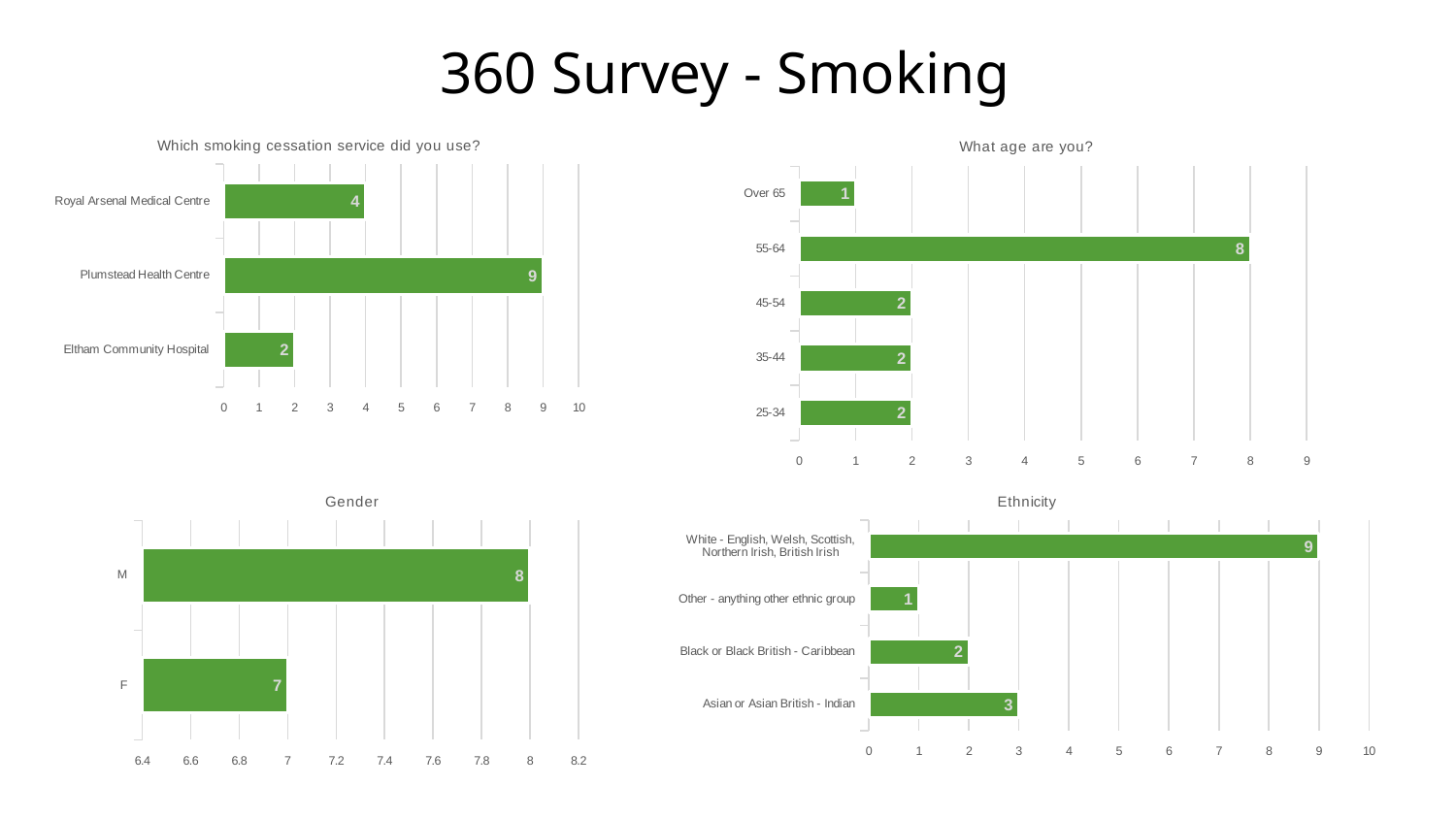
In the 'Which smoking cessation service did you use?' chart, what is the difference between Plumstead Health Centre and Royal Arsenal Medical Centre? 5 In the 'Which smoking cessation service did you use?' chart, what is the value for Plumstead Health Centre? 9 In the 'Gender' chart, what is the value for F? 7 In the 'Ethnicity' chart, what is the difference between White - English, Welsh, Scottish, Northern Irish, British Irish and Black or Black British - Caribbean? 7 In the 'What age are you?' chart, which age group has the highest value? 55-64 In the 'What age are you?' chart, how many age categories are shown? 5 In the 'Gender' chart, which is larger, M or F? M In the 'Which smoking cessation service did you use?' chart, which service has the lowest value? Eltham Community Hospital What kind of chart is the 'Ethnicity' chart? Bar chart In the 'What age are you?' chart, what is the value for 55-64? 8 In the 'What age are you?' chart, what is the total of the values for 25-34, 35-44 and 45-54? 6 In the 'Ethnicity' chart, what is the value for Asian or Asian British - Indian? 3